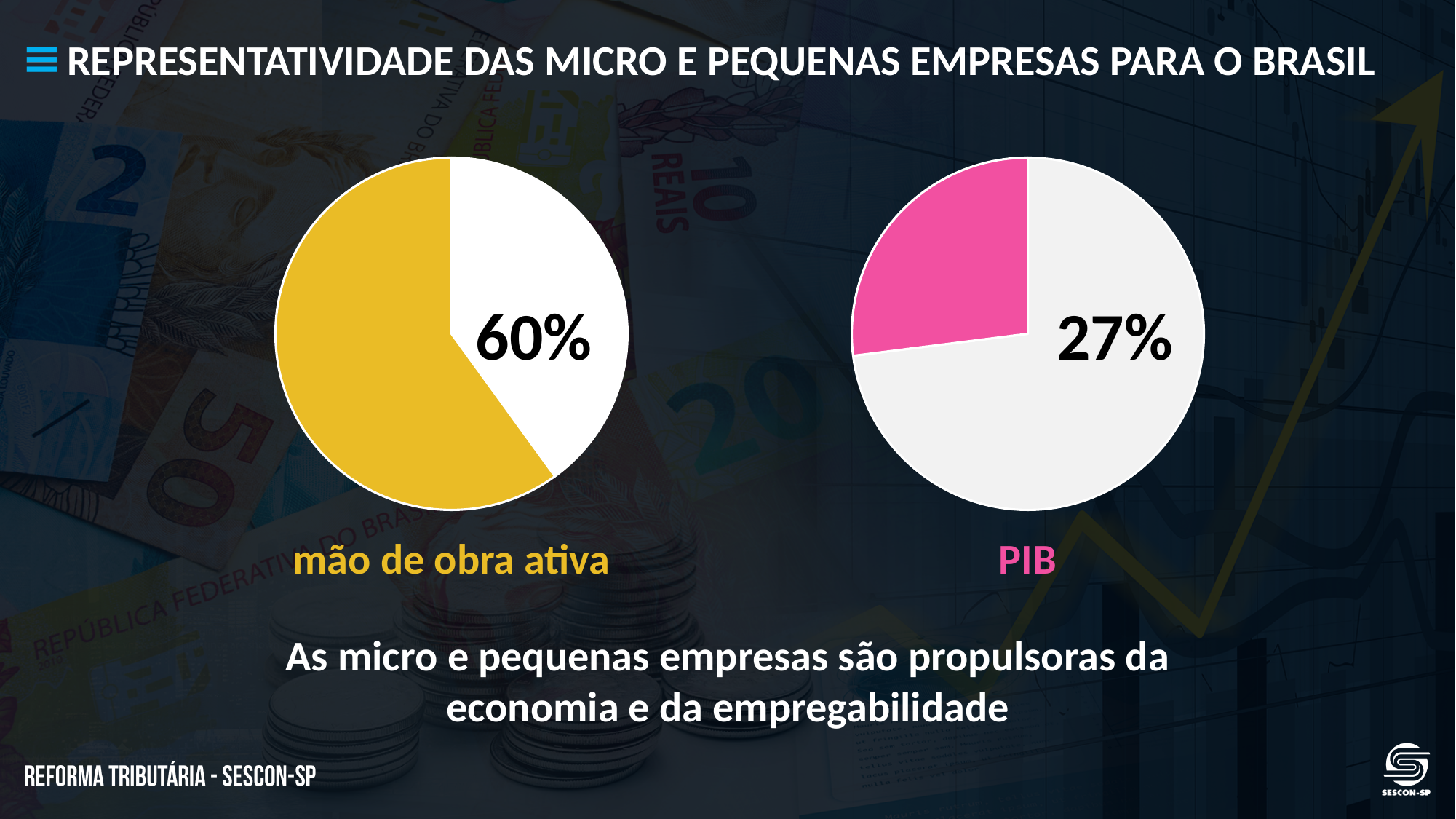
How many pie charts are on the slide? 2 What colour is the highlighted slice in the 'mão de obra ativa' pie chart? yellow What colour is the highlighted slice in the 'PIB' pie chart? pink In the 'PIB' pie chart, is the highlighted share greater or less than 50%? less In the left pie chart labelled 'mão de obra ativa', what percentage is shown? 60% What kind of chart is used for 'PIB'? pie chart What kind of chart is used for 'mão de obra ativa'? pie chart Which of the two pie charts shows the larger highlighted share, 'mão de obra ativa' or 'PIB'? mão de obra ativa What is the difference between the percentage shown in the 'mão de obra ativa' chart and the percentage shown in the 'PIB' chart? 33% In the 'mão de obra ativa' pie chart, is the highlighted share greater or less than 50%? greater In the right pie chart labelled 'PIB', what percentage is shown? 27%